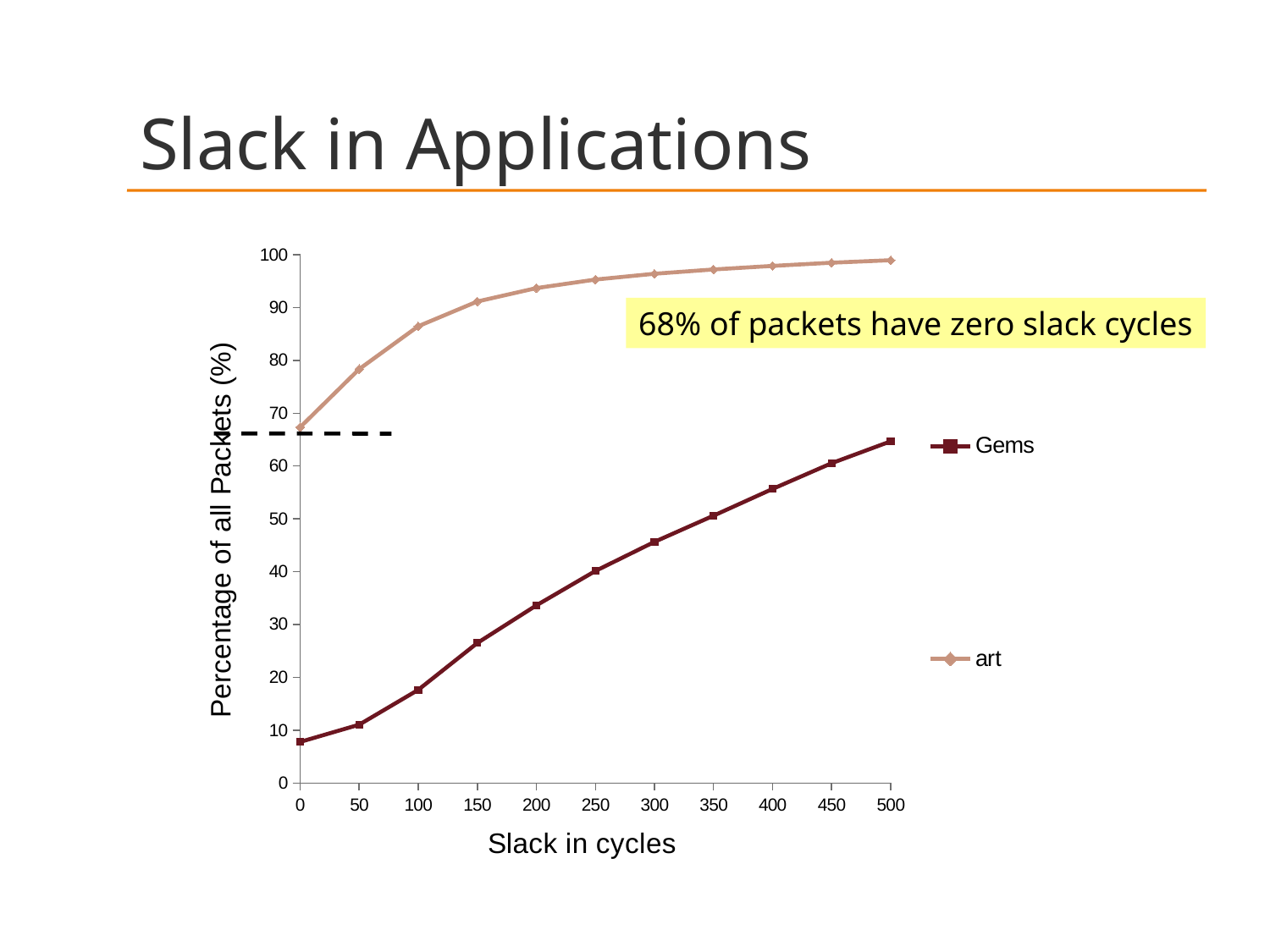
Is the value for art at a slack of 500 cycles greater or less than 90? greater How many slack values (x-axis points) are plotted for each series? 11 What are the two series named in the legend? Gems and art Is the value for Gems at a slack of 0 cycles greater or less than 10? less What kind of chart is shown on the slide? line chart How many series does the legend list? 2 What is the title of the x axis? Slack in cycles At which slack value does the Gems series reach its highest percentage? 500 Is the value for art at a slack of 0 cycles greater or less than 60? greater At a slack of 500 cycles, which series has the higher percentage of packets, Gems or art? art Does the Gems series rise or fall as slack in cycles increases? rises